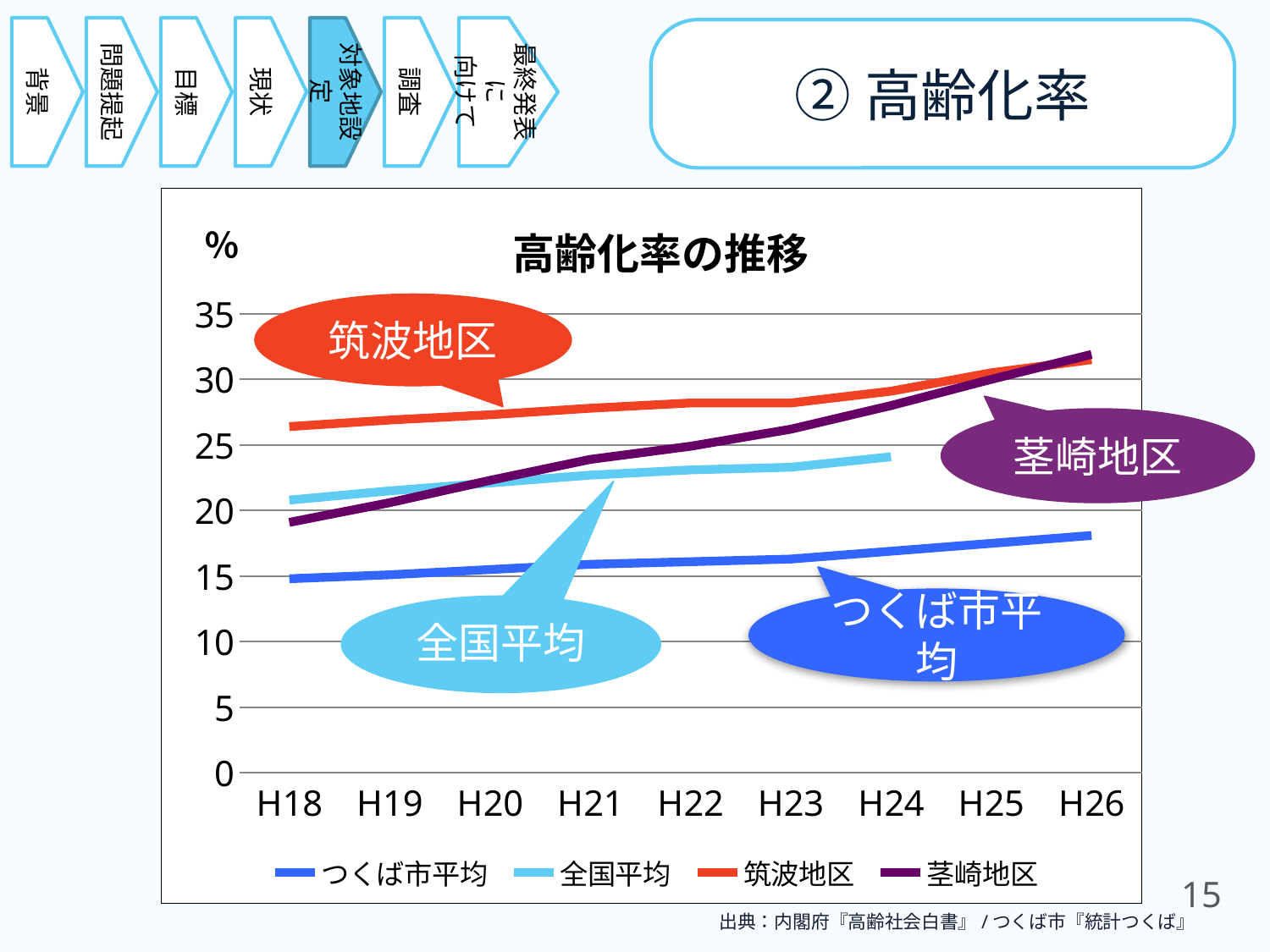
Is the value for 筑波地区 in H18 greater or less than 25? greater Which series has the lowest values across all years in the chart? つくば市平均 In H18, which is higher: 筑波地区 or 茎崎地区? 筑波地区 What kind of chart is shown on the slide? line chart How many series does the legend of the chart list? 4 What is the title of the chart? 高齢化率の推移 Is the value for 茎崎地区 in H26 greater or less than 30? greater Which series is drawn in purple in the chart? 茎崎地区 Is the value for 茎崎地区 in H18 greater or less than 20? less Does the value for 茎崎地区 rise or fall from H18 to H26? rise How many years are shown along the x axis of the chart? 9